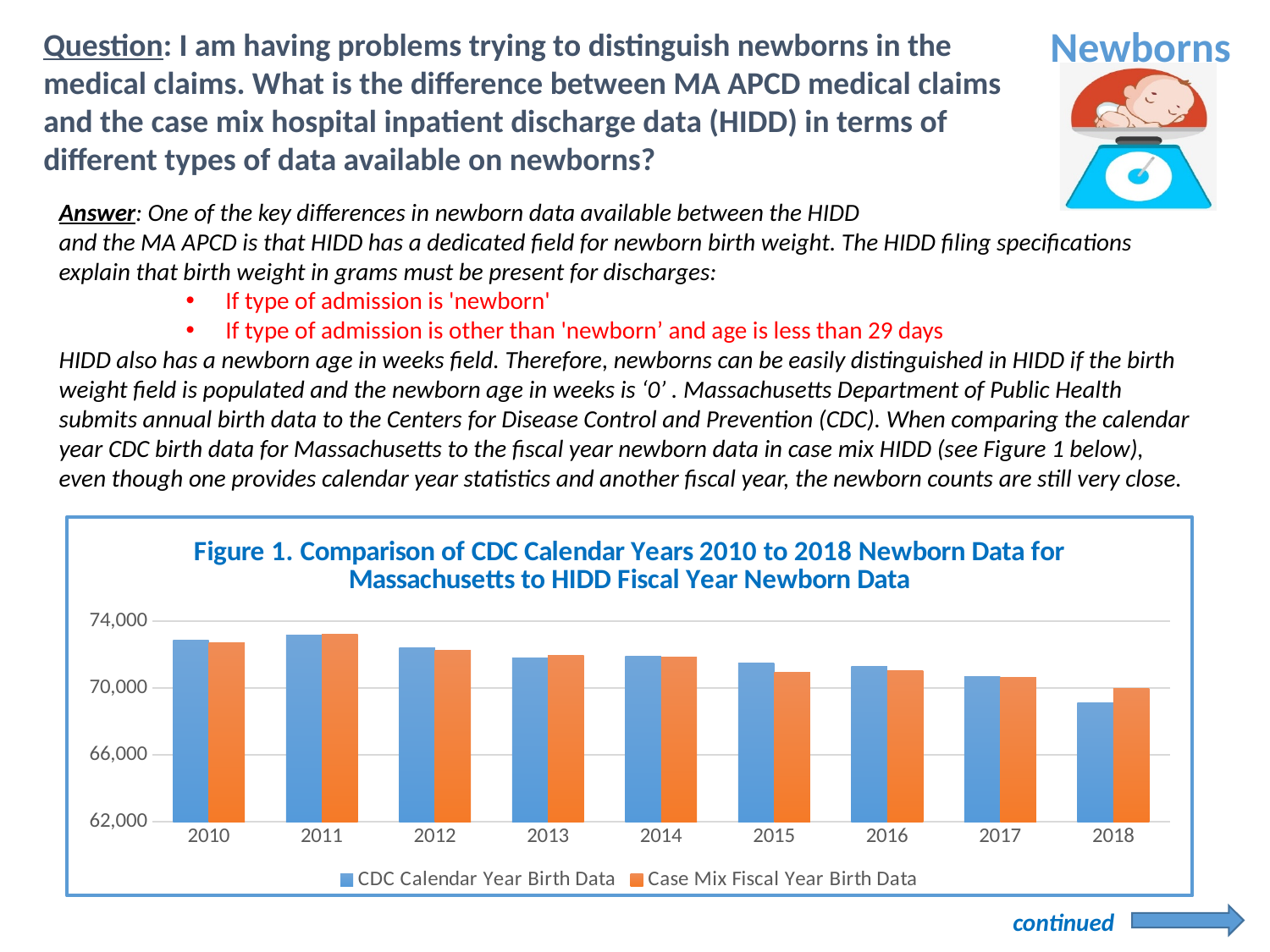
Which year has the highest Case Mix Fiscal Year Birth Data value in Figure 1? 2011 Which year has the lowest CDC Calendar Year Birth Data value in Figure 1? 2018 Which series in Figure 1 is drawn in orange? Case Mix Fiscal Year Birth Data Is the Case Mix Fiscal Year Birth Data value for 2011 greater or less than 74,000? less How many years are shown on the x axis of Figure 1? 9 Is the CDC Calendar Year Birth Data value for 2018 greater or less than 70,000? less Is the CDC Calendar Year Birth Data value for 2015 greater or less than 70,000? greater How many series does the legend of Figure 1 list? 2 What kind of chart is shown in Figure 1? bar chart Overall, do the CDC Calendar Year Birth Data values rise or fall from 2011 to 2018 in Figure 1? fall What are the two series named in the legend of Figure 1? CDC Calendar Year Birth Data and Case Mix Fiscal Year Birth Data